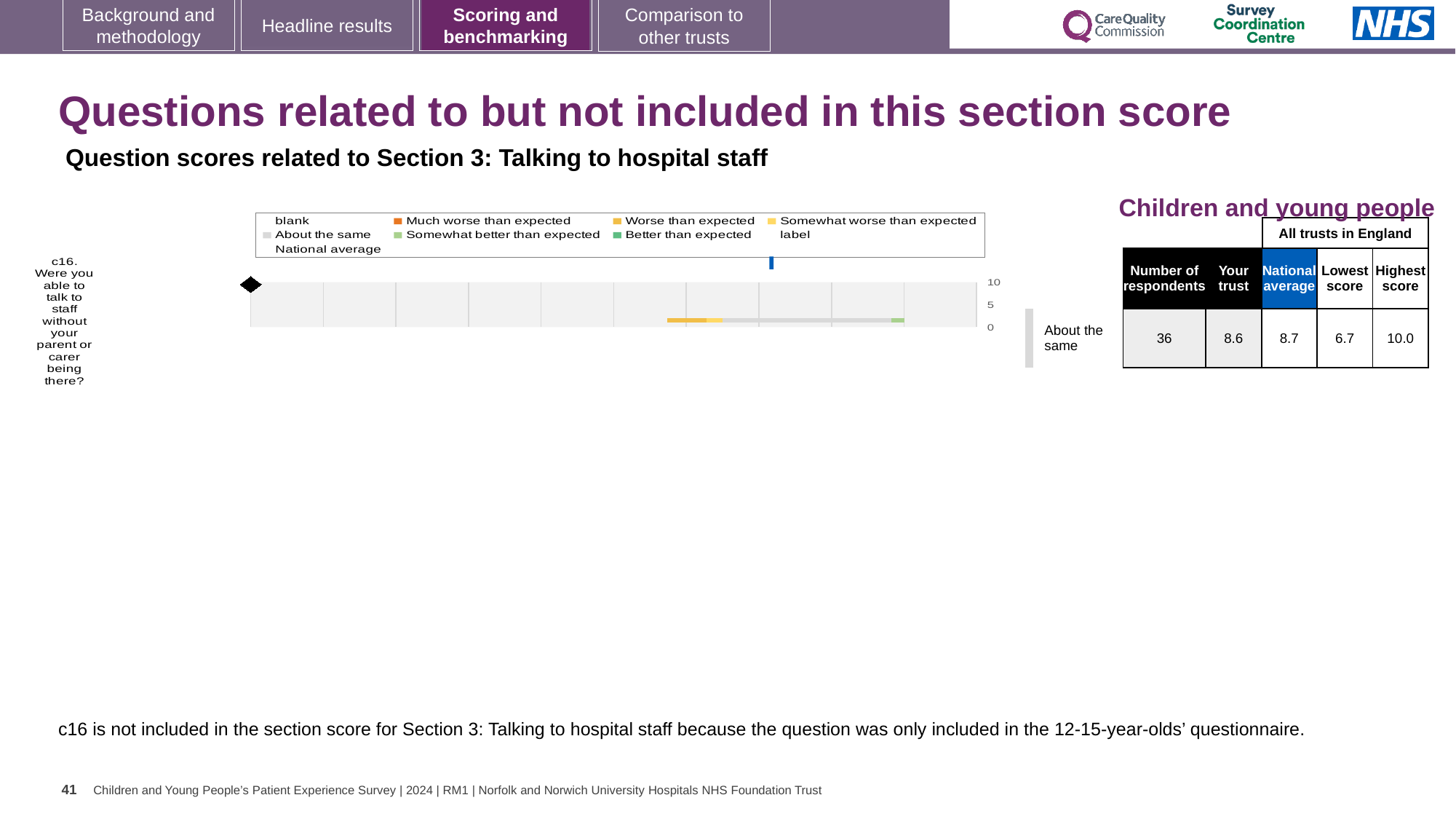
What kind of chart is used to show the c16 question score? bar chart According to the table beside the chart, how many respondents answered c16? 36 According to the table beside the chart, what is the national average score for c16? 8.7 According to the table beside the chart, what is the 'Your trust' score for c16? 8.6 For c16, what is the difference between the highest score and the lowest score among all trusts in England? 3.3 Which question number is plotted in the chart? c16 According to the table beside the chart, what is the lowest score among all trusts in England for c16? 6.7 According to the table beside the chart, what is the highest score among all trusts in England for c16? 10.0 For c16, which is larger: the 'Your trust' score or the national average score? National average What benchmark category label is shown to the right of the c16 bar? About the same What is the maximum value shown on the chart's score axis? 10 How many survey questions are plotted in the chart? 1